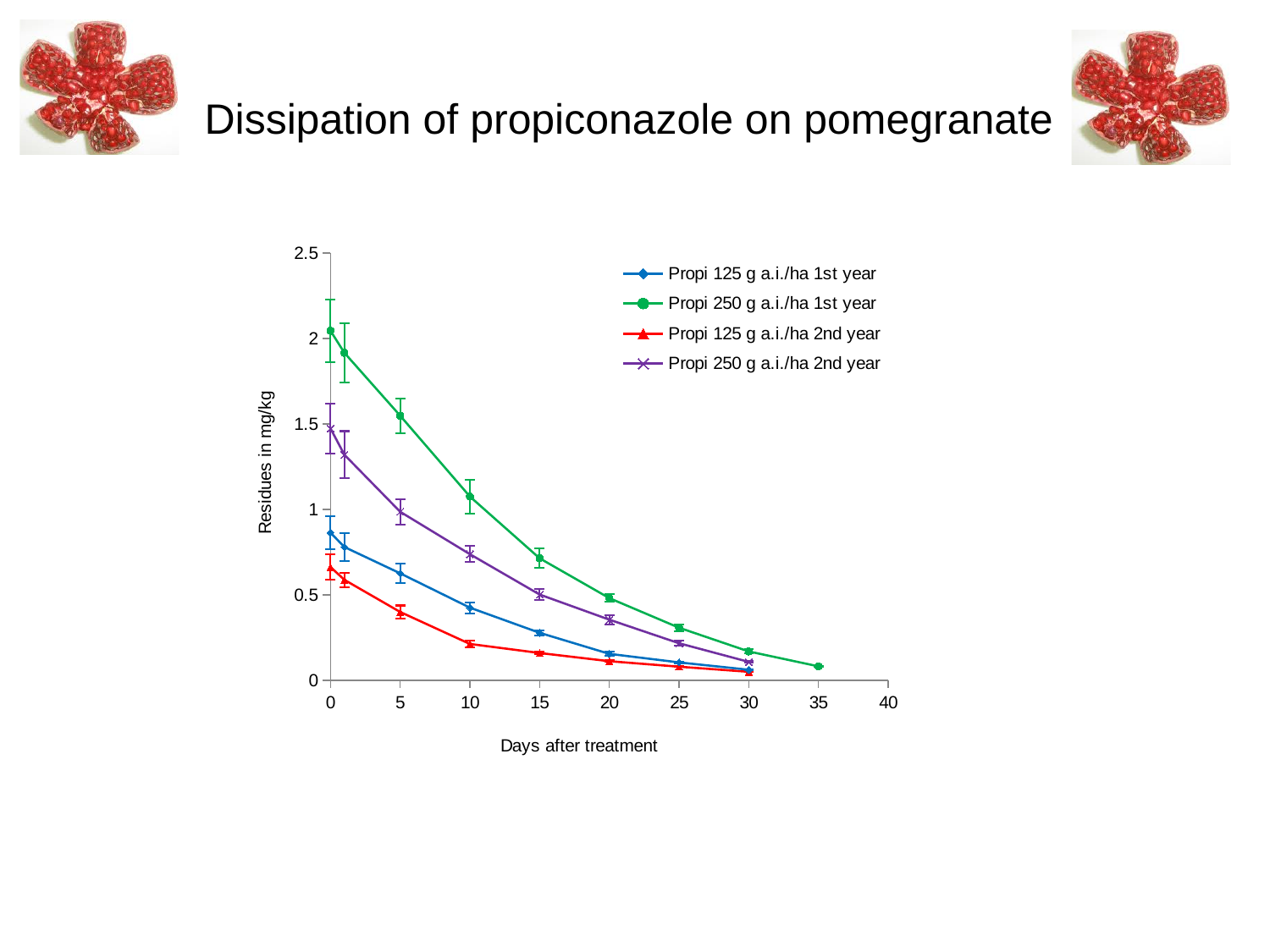
Is the residue for Propi 125 g a.i./ha 1st year at day 10 greater or less than 0.5? less Is the residue for Propi 125 g a.i./ha 2nd year at day 0 greater or less than 1? less Is the residue for Propi 250 g a.i./ha 2nd year at day 0 greater or less than 2? less Which series has the lowest residue at day 0? Propi 125 g a.i./ha 2nd year Which series is the only one with a data point at 35 days after treatment? Propi 250 g a.i./ha 1st year What kind of chart is shown on the slide? Line chart Which series has the highest residue at day 0? Propi 250 g a.i./ha 1st year At day 10, which is higher: Propi 250 g a.i./ha 2nd year or Propi 125 g a.i./ha 1st year? Propi 250 g a.i./ha 2nd year What is the label of the y axis? Residues in mg/kg Do the residue values rise or fall as days after treatment increase? Fall How many series does the legend list? 4